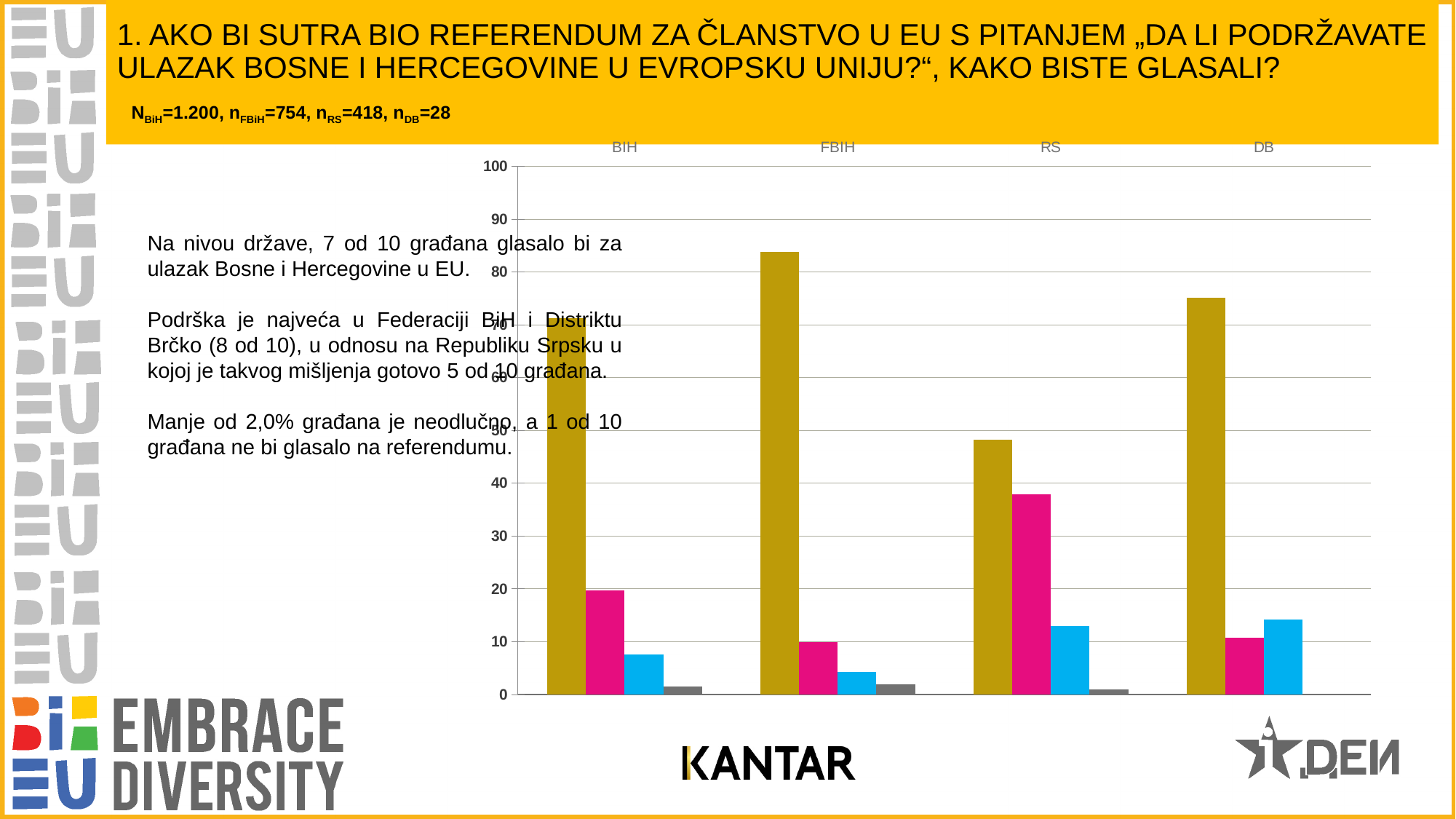
For RS, which is larger: the gold bar or the magenta bar? the gold bar Which category has the shortest gold bar? RS Is the value of the gold bar for RS greater or less than 50? less What is the highest value shown on the chart's y axis? 100 Which category has the tallest gold bar? FBIH Is the value of the gold bar for BIH greater or less than 60? greater Is the value of the gold bar for FBIH greater or less than 80? greater How many categories are shown along the x axis of the chart? 4 What kind of chart is shown on the slide? bar chart For DB, which is larger: the blue bar or the magenta bar? the blue bar